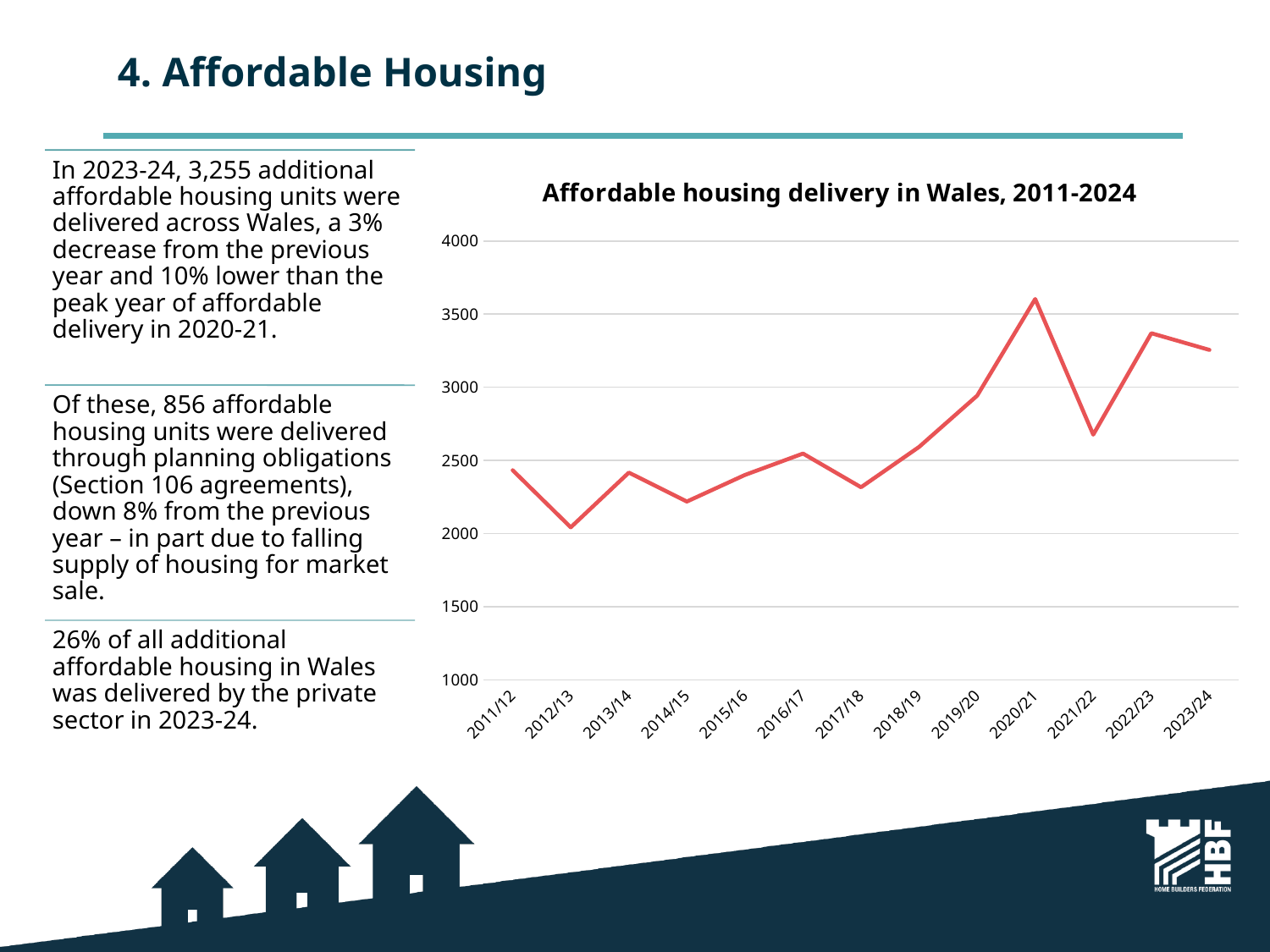
Which is larger, the value for 2013/14 or the value for 2014/15? 2013/14 Is the value for 2014/15 greater or less than 2500? less Is the value for 2022/23 greater or less than 3500? less Which is larger, the value for 2020/21 or the value for 2021/22? 2020/21 How many years are plotted on the x axis of the chart? 13 Which year has the highest value on the chart? 2020/21 What kind of chart is shown on the slide? line chart What is the title of the chart? Affordable housing delivery in Wales, 2011-2024 Is the value for 2020/21 greater or less than 3500? greater Which year has the lowest value on the chart? 2012/13 Overall, do the values rise or fall from 2011/12 to 2023/24? rise